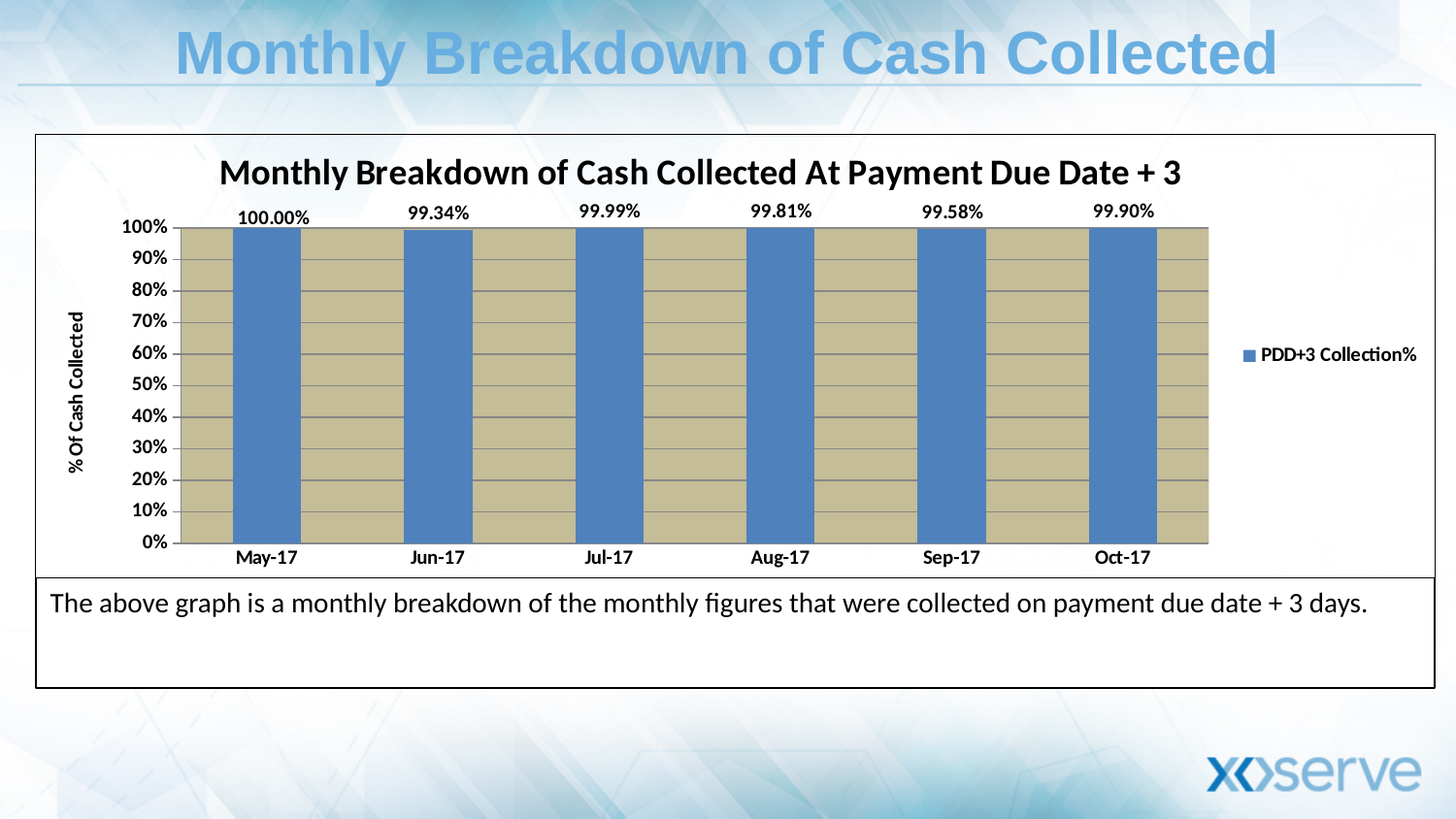
What is the PDD+3 Collection% value for Jun-17? 99.34% How many series does the chart legend list? 1 Which month has the lowest PDD+3 Collection% value? Jun-17 What is the title of the chart? Monthly Breakdown of Cash Collected At Payment Due Date + 3 What kind of chart is shown on the slide? Bar chart What is the PDD+3 Collection% value for May-17? 100.00% What is the PDD+3 Collection% value for Sep-17? 99.58% What is the PDD+3 Collection% value for Oct-17? 99.90% Which month has the highest PDD+3 Collection% value? May-17 What is the difference between the PDD+3 Collection% values for May-17 and Jun-17? 0.66% How many months are shown on the x axis of the chart? 6 Which has a higher PDD+3 Collection% value, Jul-17 or Aug-17? Jul-17